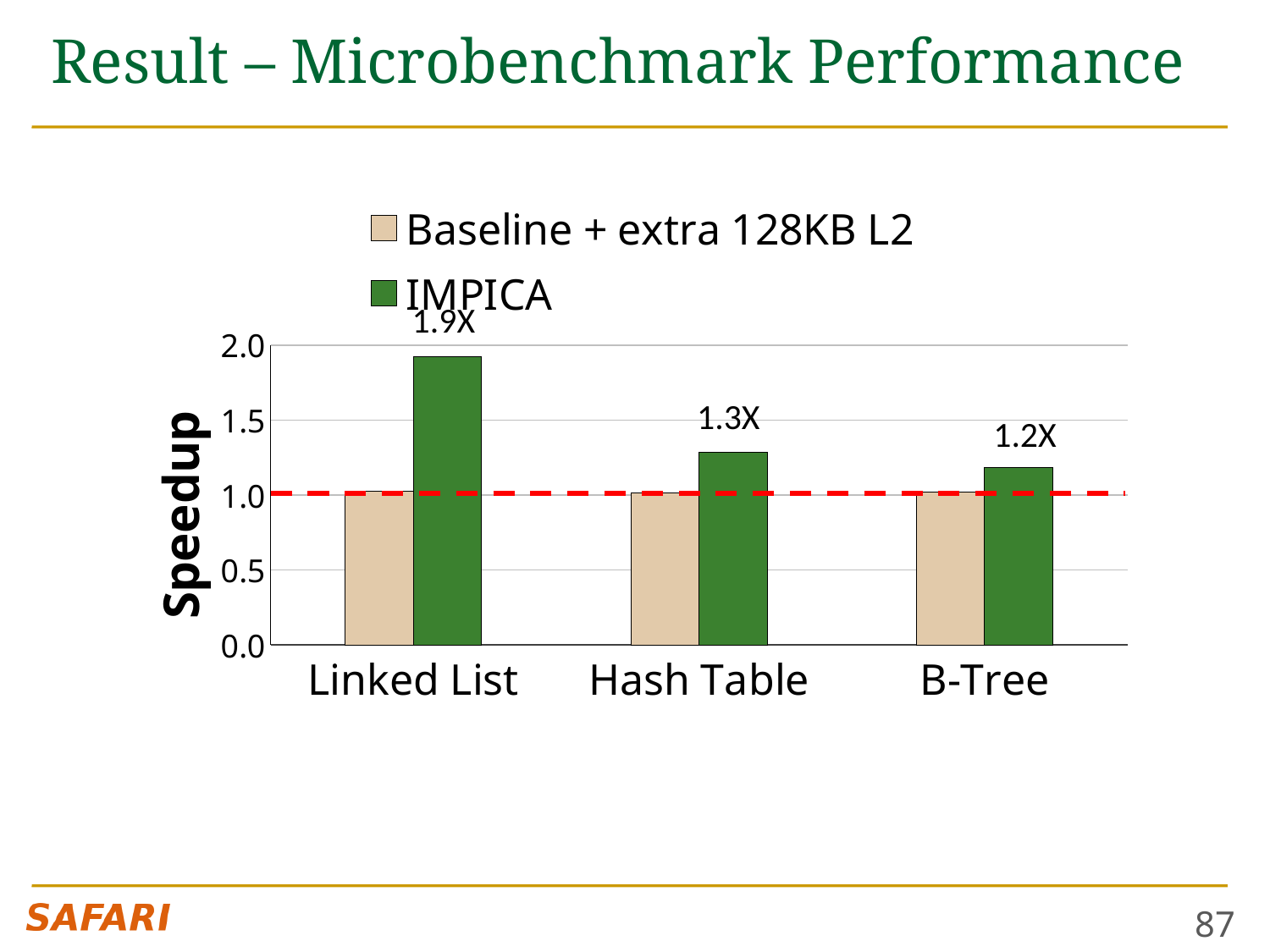
How many series does the legend list? 2 Is the IMPICA speedup for Linked List greater or less than 1.5? greater What kind of chart is shown on the slide? bar chart What is the IMPICA speedup for B-Tree? 1.2X How many benchmarks are shown on the x axis? 3 What is the IMPICA speedup for Hash Table? 1.3X Which benchmark has the highest IMPICA speedup? Linked List Is the IMPICA speedup for B-Tree greater or less than 1.5? less Which benchmark has the lowest IMPICA speedup? B-Tree Which has the larger IMPICA speedup, Hash Table or B-Tree? Hash Table What is the IMPICA speedup for Linked List? 1.9X What is the difference between the IMPICA speedup for Linked List and for B-Tree? 0.7X